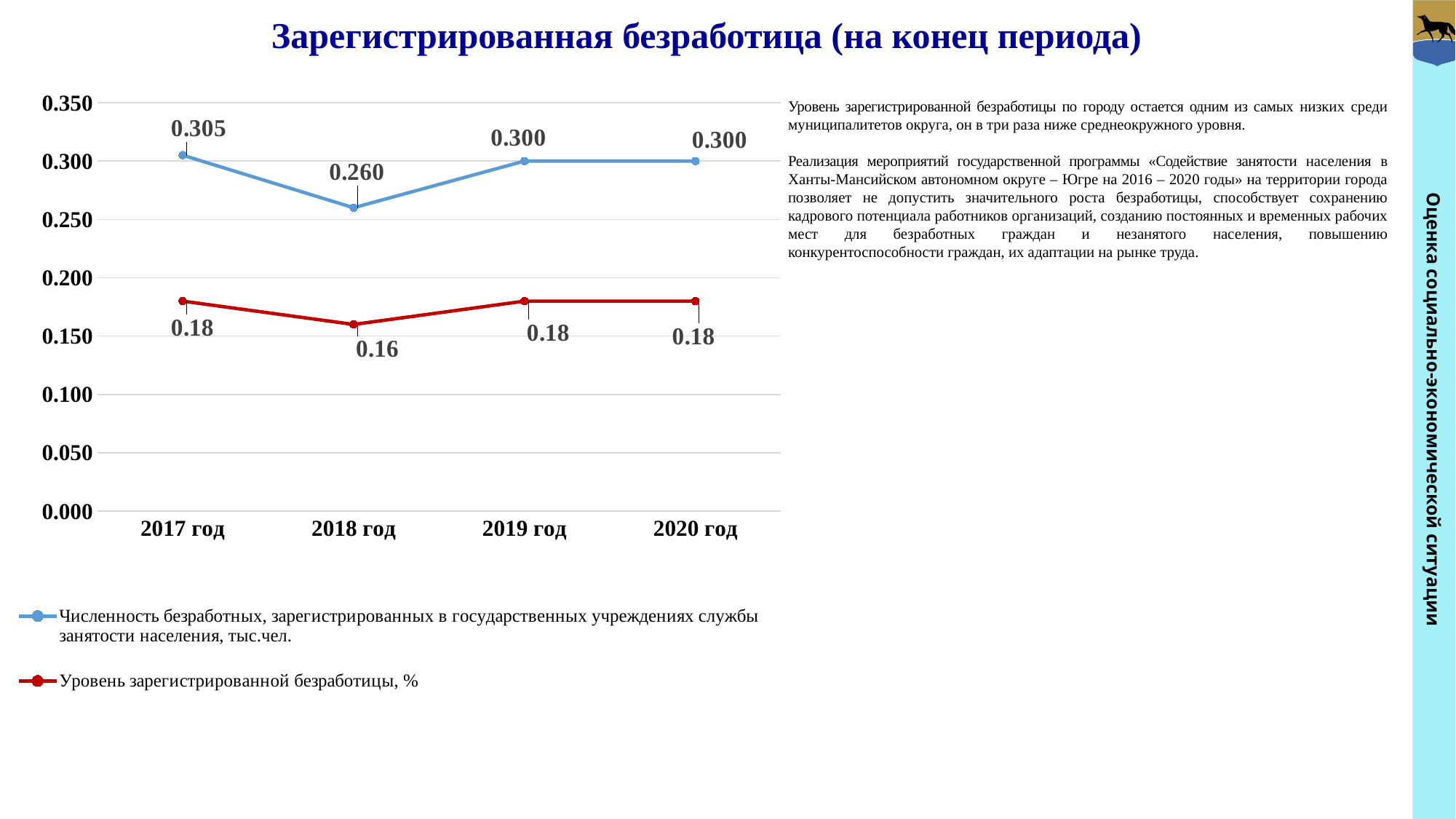
What is the value of the red series (Уровень зарегистрированной безработицы, %) for 2018 год? 0.16 What type of chart is shown on the slide? Line chart In which year is the red series (Уровень зарегистрированной безработицы, %) at its lowest? 2018 год Which is larger for 2019 год: the blue series value or the red series value? The blue series (0.300) How many years are shown on the x axis? 4 In which year is the blue series (Численность безработных, тыс.чел.) at its highest? 2017 год What is the title of the chart? Зарегистрированная безработица (на конец периода) What is the value of the blue series (Численность безработных, тыс.чел.) for 2017 год? 0.305 How many series does the legend list? 2 What is the value of the red series (Уровень зарегистрированной безработицы, %) for 2020 год? 0.18 What is the difference between the blue series values for 2017 год and 2018 год? 0.045 What is the value of the blue series (Численность безработных, тыс.чел.) for 2018 год? 0.260